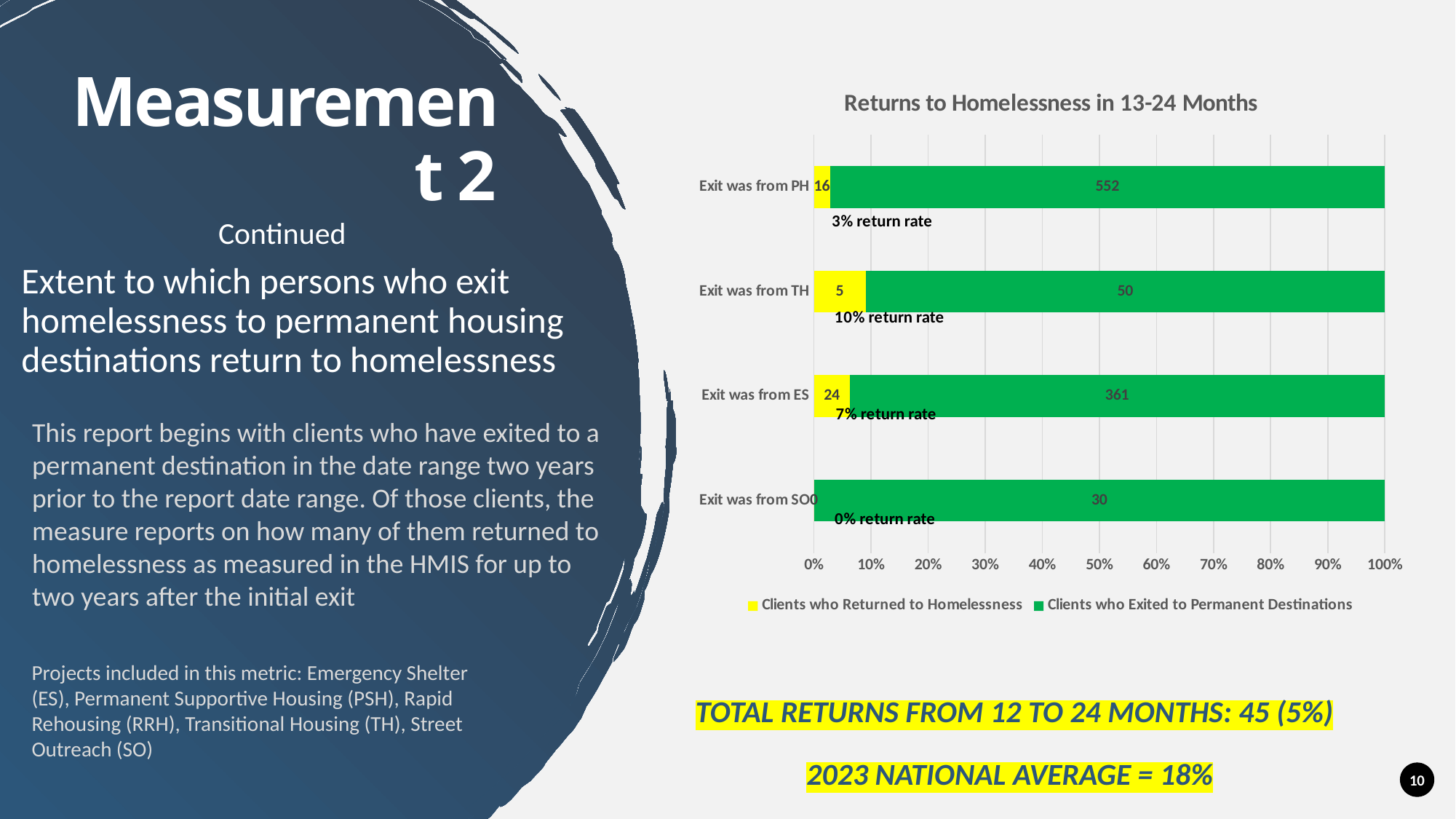
How many series does the chart legend list? 2 What is the return rate for clients whose exit was from TH? 10% return rate What type of chart is shown on the slide? Stacked bar chart What colour represents Clients who Returned to Homelessness in the chart? Yellow Which exit category has the highest number of clients who exited to permanent destinations? Exit was from PH How many clients who exited from ES exited to permanent destinations? 361 Which is larger: the number of clients who returned to homelessness from ES or from TH? Exit was from ES What is the title of the chart? Returns to Homelessness in 13-24 Months How many clients who exited from PH returned to homelessness? 16 What is the difference between the number of clients who exited to permanent destinations from PH and from ES? 191 Which exit category has the lowest number of clients who returned to homelessness? Exit was from SO How many exit categories are shown on the chart? 4